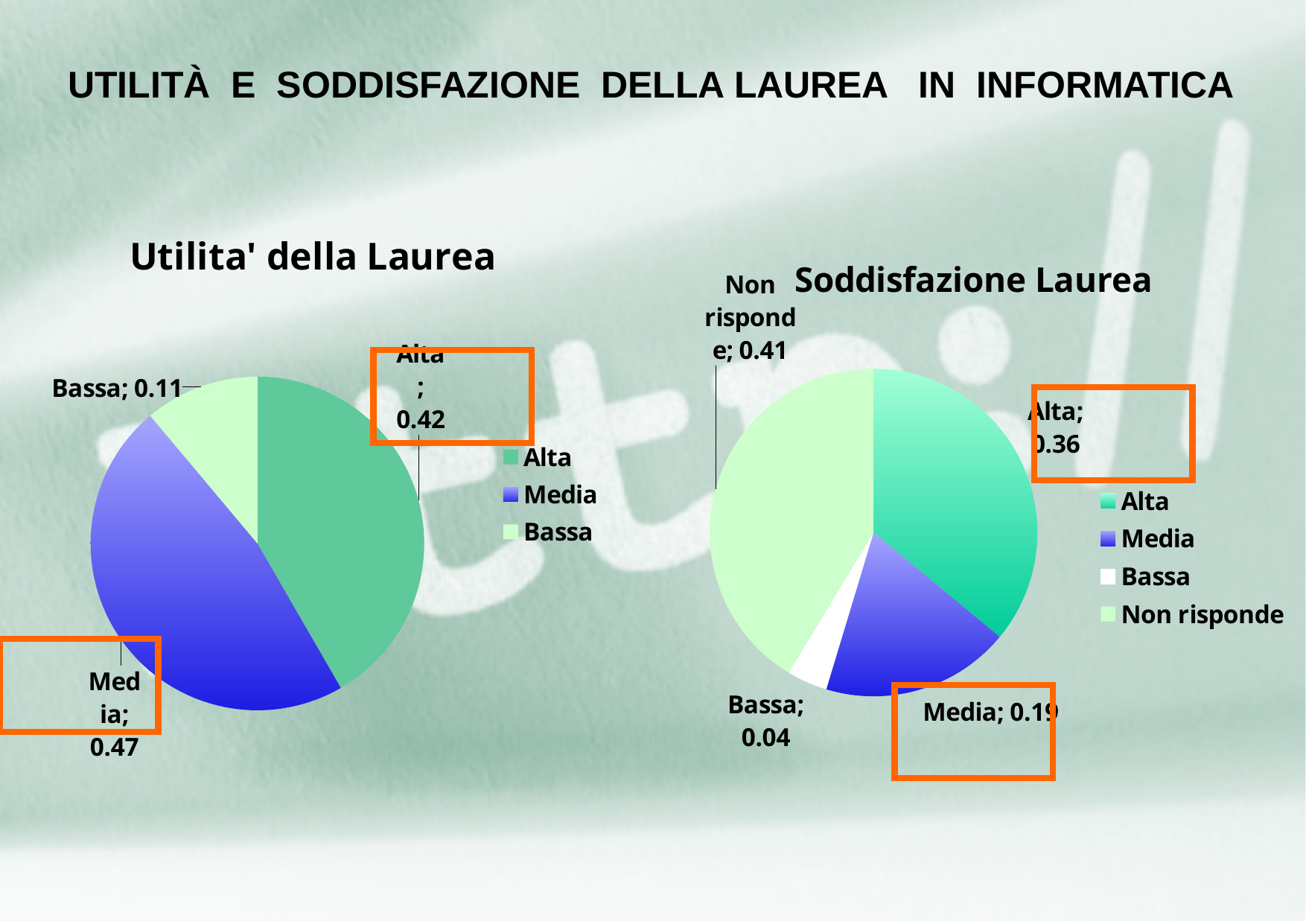
In the 'Utilita' della Laurea' chart, what is the value for Bassa? 0.11 In the 'Soddisfazione Laurea' chart, which category has the smallest slice? Bassa In the 'Utilita' della Laurea' chart, which category has the largest slice? Media What type of chart is the 'Soddisfazione Laurea' chart? Pie chart In the 'Soddisfazione Laurea' chart, which is larger, Alta or Media? Alta How many entries does the legend of the 'Soddisfazione Laurea' chart list? 4 In the 'Utilita' della Laurea' chart, how many slices does the pie have? 3 In the 'Soddisfazione Laurea' chart, what is the value for Media? 0.19 In the 'Soddisfazione Laurea' chart, what is the value for Non risponde? 0.41 In the 'Utilita' della Laurea' chart, what is the difference between the Alta and Bassa values? 0.31 In the 'Utilita' della Laurea' chart, what is the value for Media? 0.47 In the 'Soddisfazione Laurea' chart, what is the difference between the Alta and Media values? 0.17